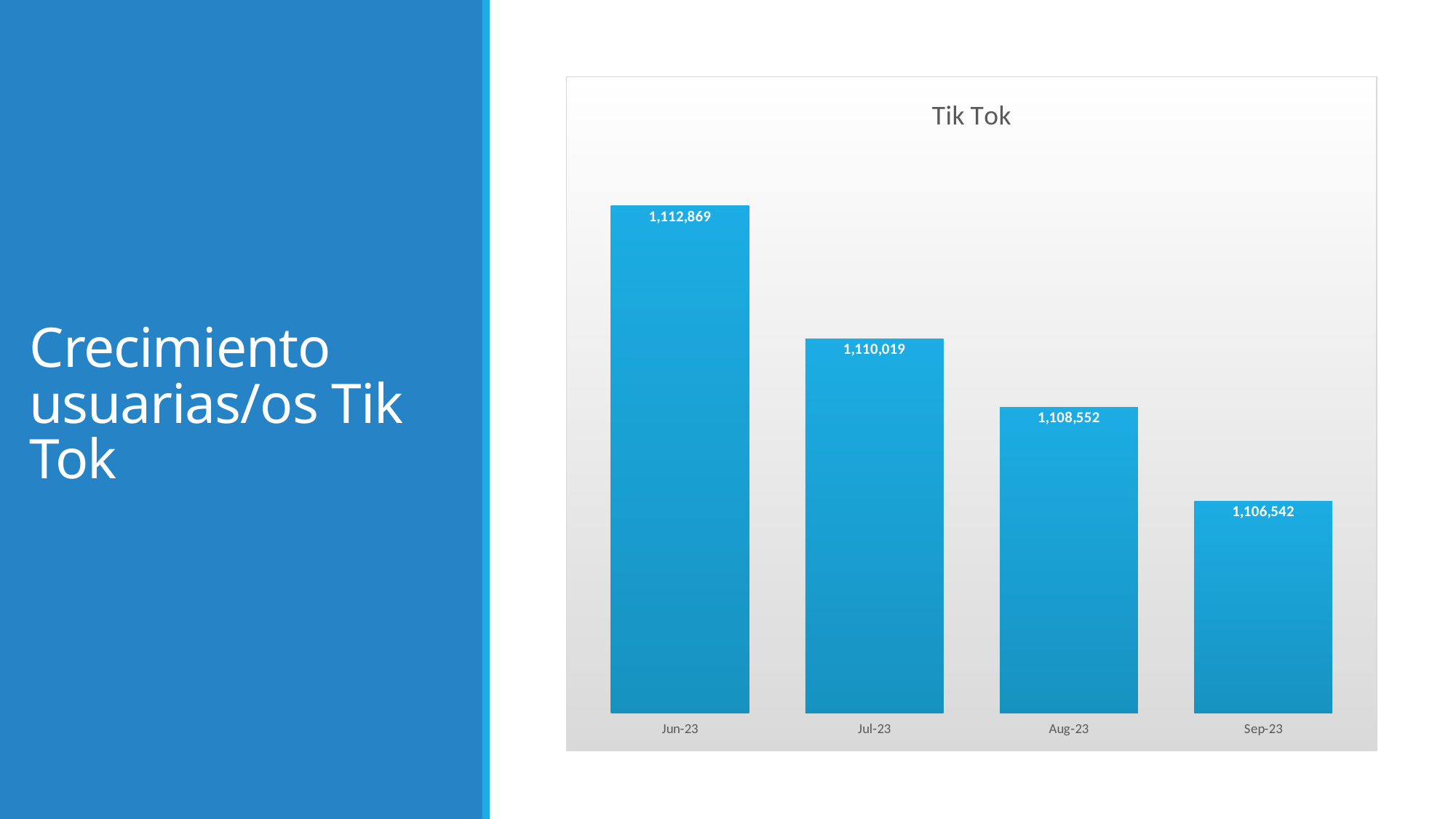
What is the difference between the values for Jun-23 and Sep-23? 6,327 Which month has the lowest value? Sep-23 Which is larger, the value for Jul-23 or the value for Aug-23? Jul-23 What is the value for Jun-23? 1,112,869 What kind of chart is shown? Bar chart What is the value for Sep-23? 1,106,542 How many months are shown on the chart? 4 Which month has the highest value? Jun-23 What is the value for Aug-23? 1,108,552 What is the value for Jul-23? 1,110,019 What is the difference between the values for Jul-23 and Aug-23? 1,467 Do the values rise or fall from Jun-23 to Sep-23? Fall